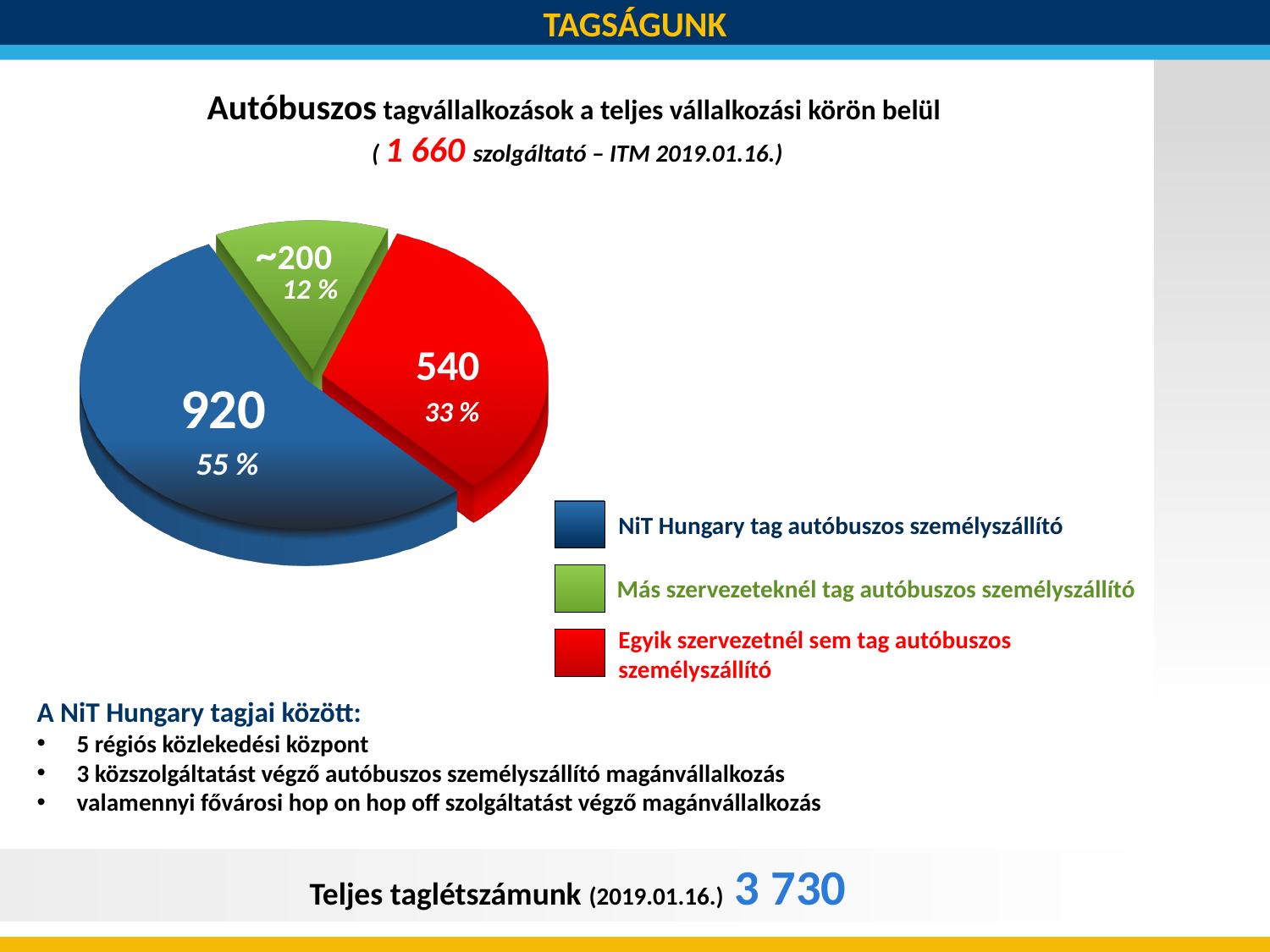
What share of the pie does the Egyik szervezetnél sem tag autóbuszos személyszállító slice represent? 33 % Which slice of the pie chart is the largest? NiT Hungary tag autóbuszos személyszállító Which slice of the pie chart is the smallest? Más szervezeteknél tag autóbuszos személyszállító Which colour represents the Egyik szervezetnél sem tag autóbuszos személyszállító slice in the pie chart? red What kind of chart is shown on the slide? pie chart How many entries does the legend of the pie chart list? 3 How many slices does the pie chart have? 3 What share of the pie does the Más szervezeteknél tag autóbuszos személyszállító slice represent? 12 % What is the value shown for the Egyik szervezetnél sem tag autóbuszos személyszállító slice? 540 What is the difference between the NiT Hungary tag autóbuszos személyszállító value and the Egyik szervezetnél sem tag autóbuszos személyszállító value? 380 What share of the pie does the NiT Hungary tag autóbuszos személyszállító slice represent? 55 % What is the value shown for the NiT Hungary tag autóbuszos személyszállító slice? 920